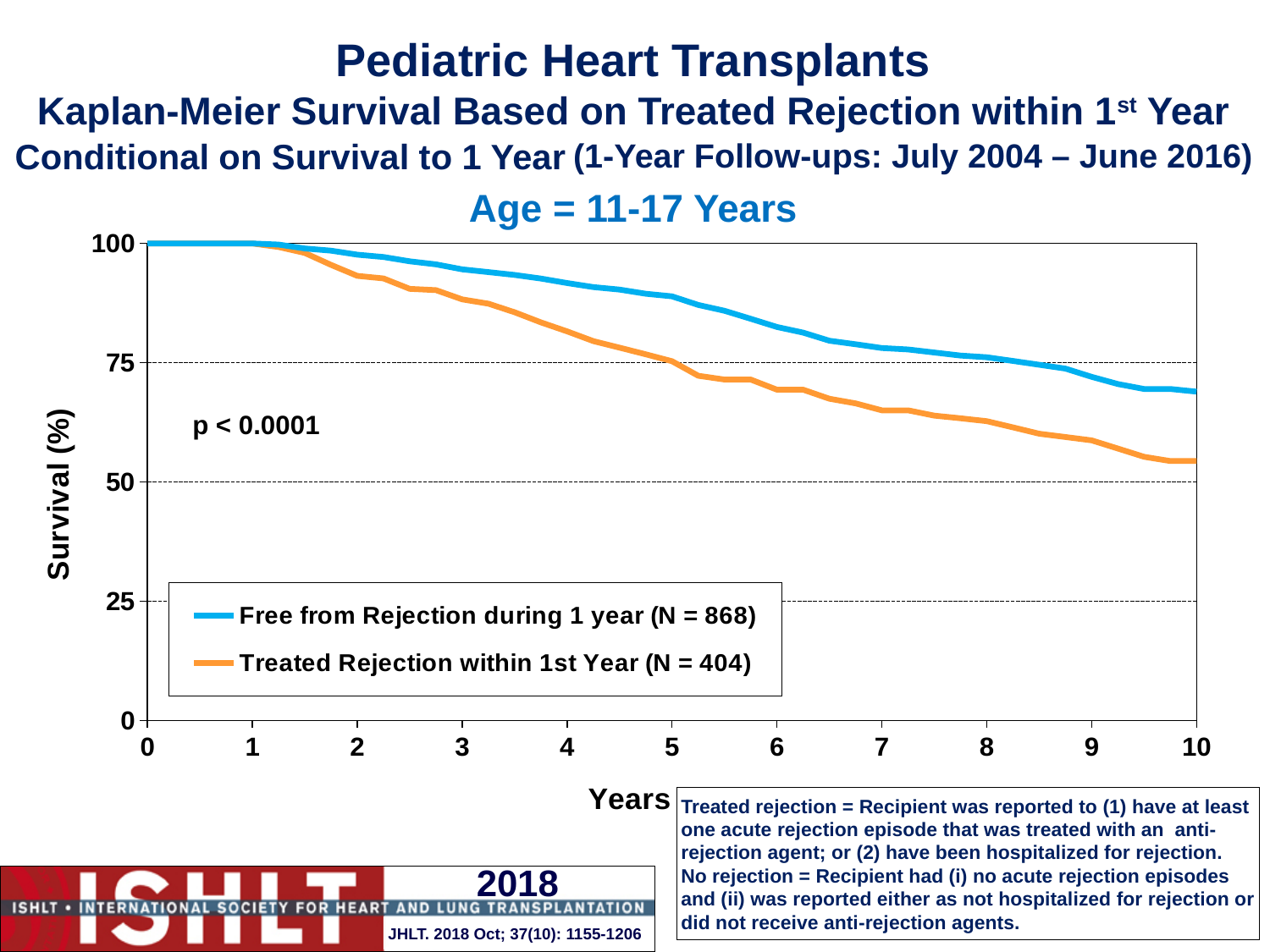
What kind of chart is shown on the slide? Line chart Is the survival for 'Treated Rejection within 1st Year' at 10 years greater or less than 50? greater Is the survival for 'Free from Rejection during 1 year' at 10 years greater or less than 75? less What is the N for the 'Treated Rejection within 1st Year' series? 404 How many series does the legend list? 2 At 10 years, which series has the higher survival: 'Free from Rejection during 1 year' or 'Treated Rejection within 1st Year'? Free from Rejection during 1 year Is the survival for 'Treated Rejection within 1st Year' at 8 years greater or less than 75? less What is the N for the 'Free from Rejection during 1 year' series? 868 What is the maximum value shown on the x axis (Years)? 10 Do the survival curves rise or fall as years increase? Fall